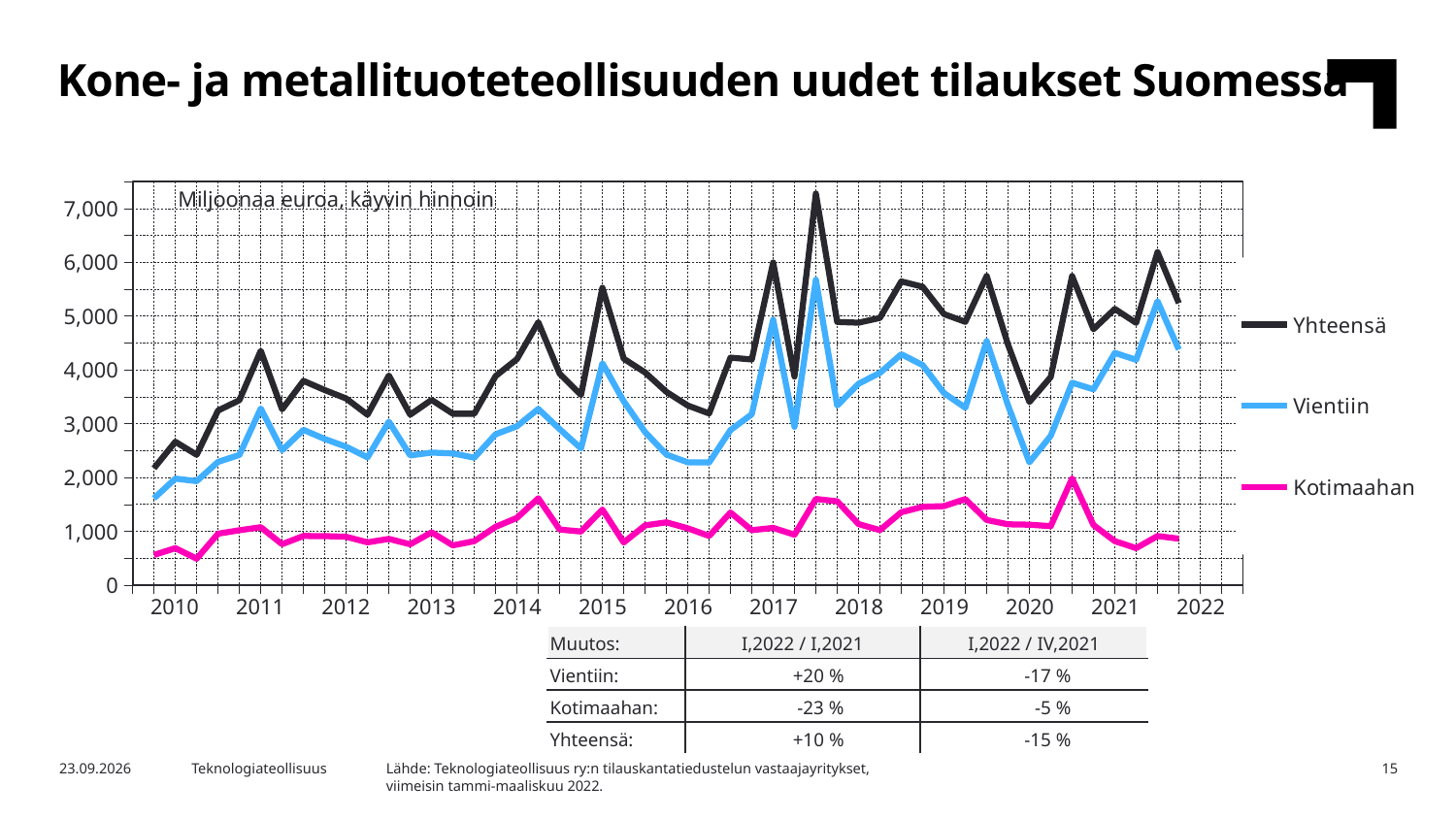
Which series has the highest values throughout the chart? Yhteensä Which series is larger in 2018, Vientiin or Kotimaahan? Vientiin Is the peak value of Yhteensä in 2017 greater or less than 7,000? greater Is the value for Vientiin at the start of 2010 greater or less than 2,000? less What colour is the Kotimaahan line? Pink Is the value for Yhteensä at the start of 2010 greater or less than 3,000? less How many series does the chart legend list? 3 Does the Vientiin series rise or fall from its low point in 2020 to the end of 2021? rise Which series has the lowest values throughout the chart? Kotimaahan What kind of chart is shown on the slide? Line chart What unit is stated inside the chart area? Miljoonaa euroa, käyvin hinnoin